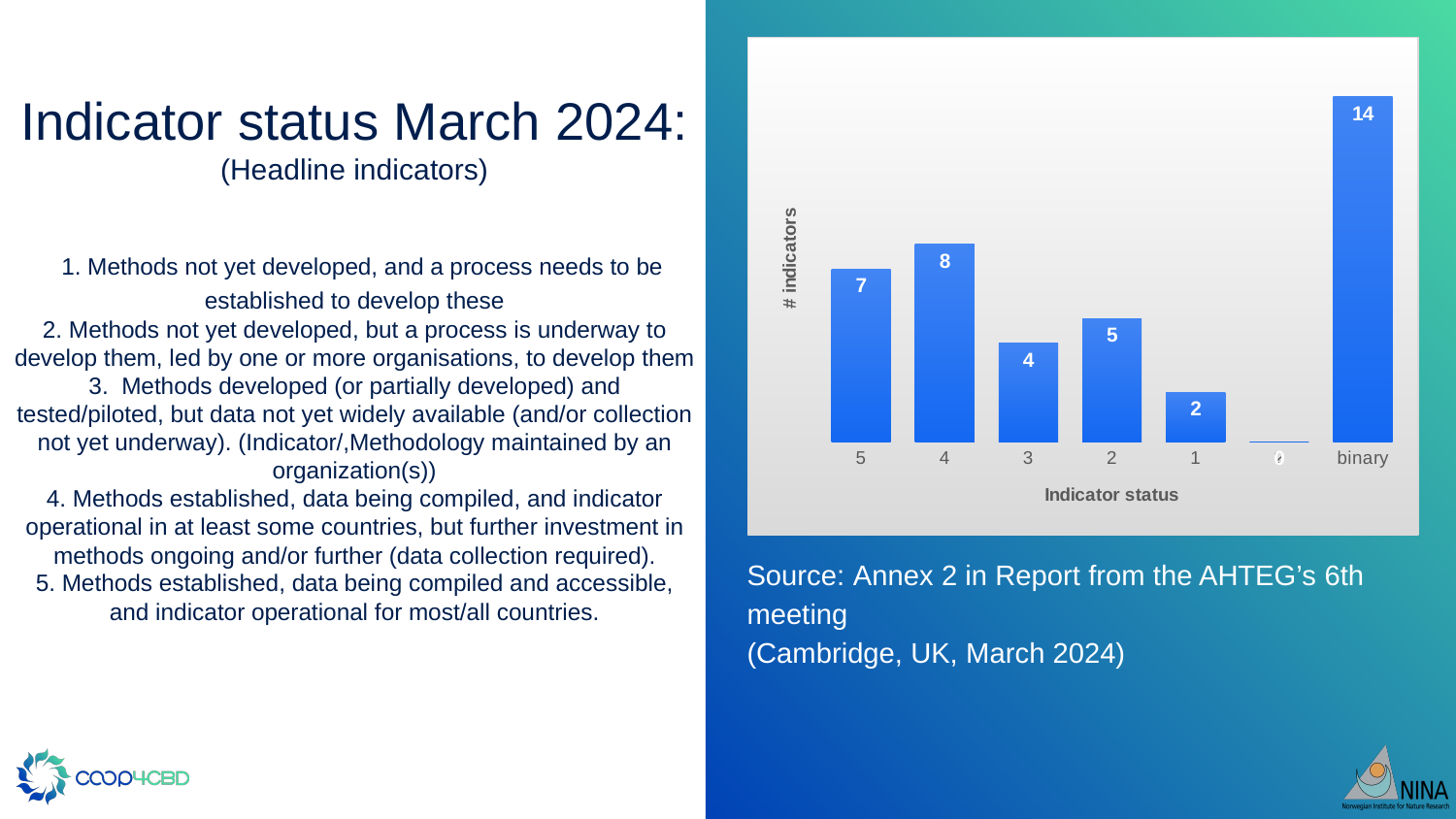
What is the value for indicator status 3? 4 What is the value for indicator status 1? 2 What is the value for indicator status 5? 7 What kind of chart is shown on the slide? bar chart What is the value for indicator status 4? 8 Which category has the highest number of indicators? binary What is the value for indicator status 2? 5 Which is larger, the value for status 5 or the value for status 4? status 4 What is the label of the horizontal axis of the chart? Indicator status What is the difference between the value for 'binary' and the value for status 4? 6 What is the value for the 'binary' category? 14 What is the label of the vertical axis of the chart? # indicators